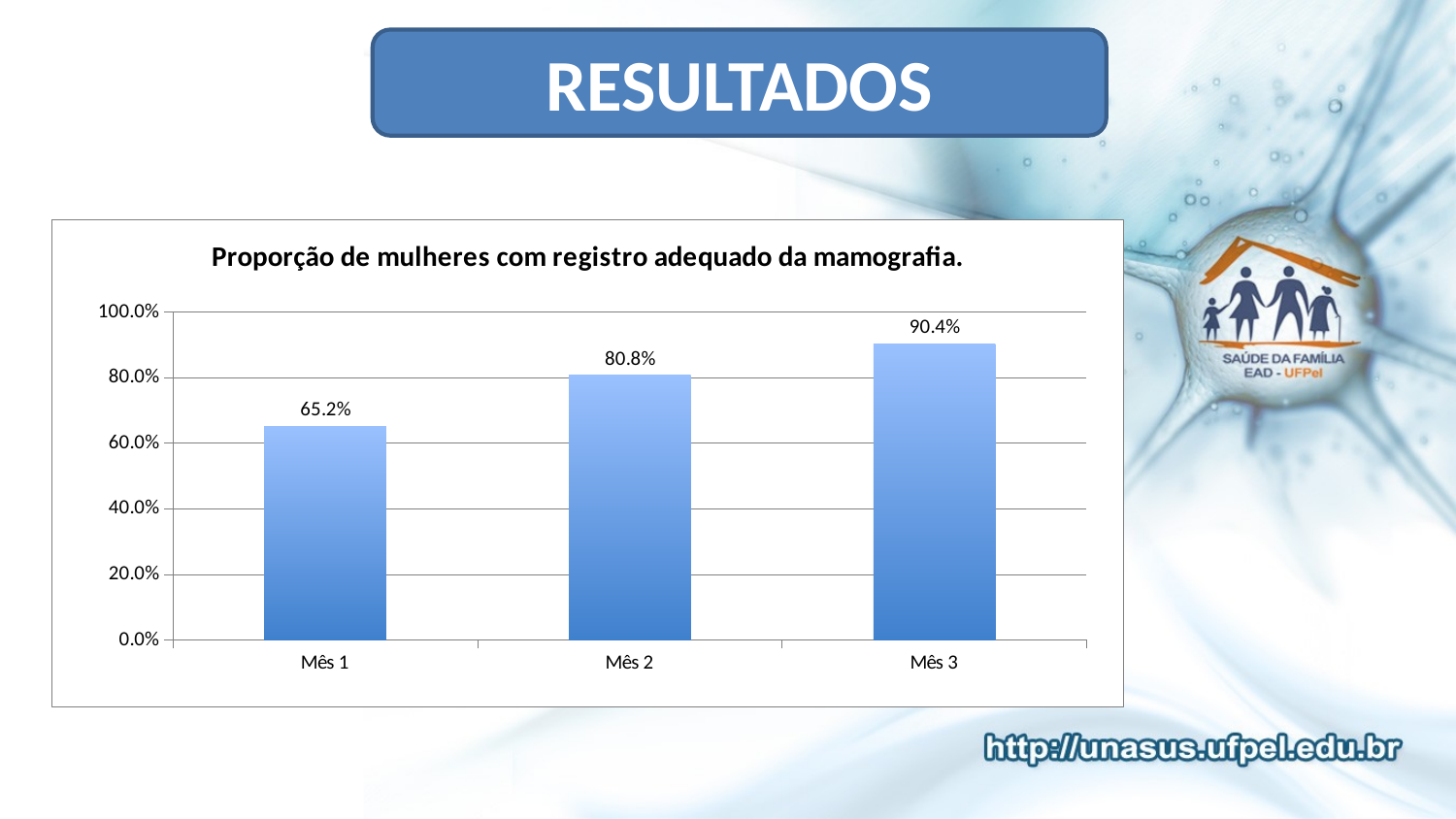
What kind of chart is shown on the slide? Bar chart Which month has the lowest proportion? Mês 1 Which is larger, the value for Mês 2 or the value for Mês 3? Mês 3 How many categories are shown on the x axis? 3 What is the difference between the values for Mês 3 and Mês 1? 25.2% Which month has the highest proportion? Mês 3 What is the value for Mês 2? 80.8% What is the value for Mês 1? 65.2% What is the difference between the values for Mês 2 and Mês 1? 15.6% What is the value for Mês 3? 90.4% Do the values rise or fall from Mês 1 to Mês 3? Rise Is the value for Mês 2 greater or less than 80.0%? greater